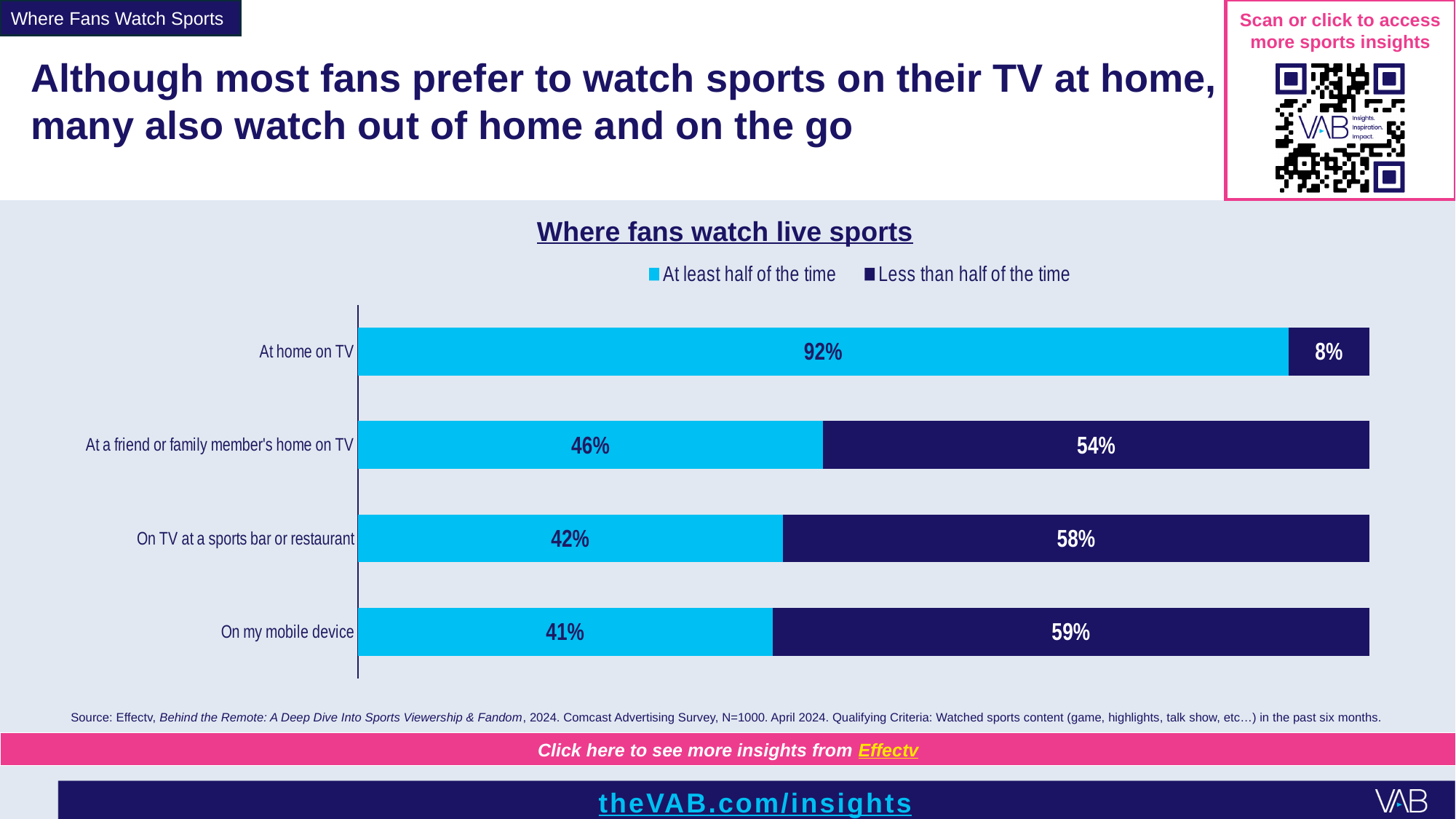
How many series does the legend list? 2 How many locations are shown in the chart? 4 Which is larger: the 'At least half of the time' value for 'At a friend or family member's home on TV' or for 'On my mobile device'? At a friend or family member's home on TV What percentage of fans watch live sports at home on TV at least half of the time? 92% What percentage of fans watch live sports on their mobile device less than half of the time? 59% What is the 'At least half of the time' value for 'On TV at a sports bar or restaurant'? 42% What is the difference between the 'At least half of the time' values for 'At home on TV' and 'At a friend or family member's home on TV'? 46% Which location has the lowest 'Less than half of the time' share? At home on TV What is the title of the chart? Where fans watch live sports What kind of chart is shown on the slide? Stacked bar chart Which location has the highest 'At least half of the time' share? At home on TV What is the total of the two segments for the 'On TV at a sports bar or restaurant' bar? 100%